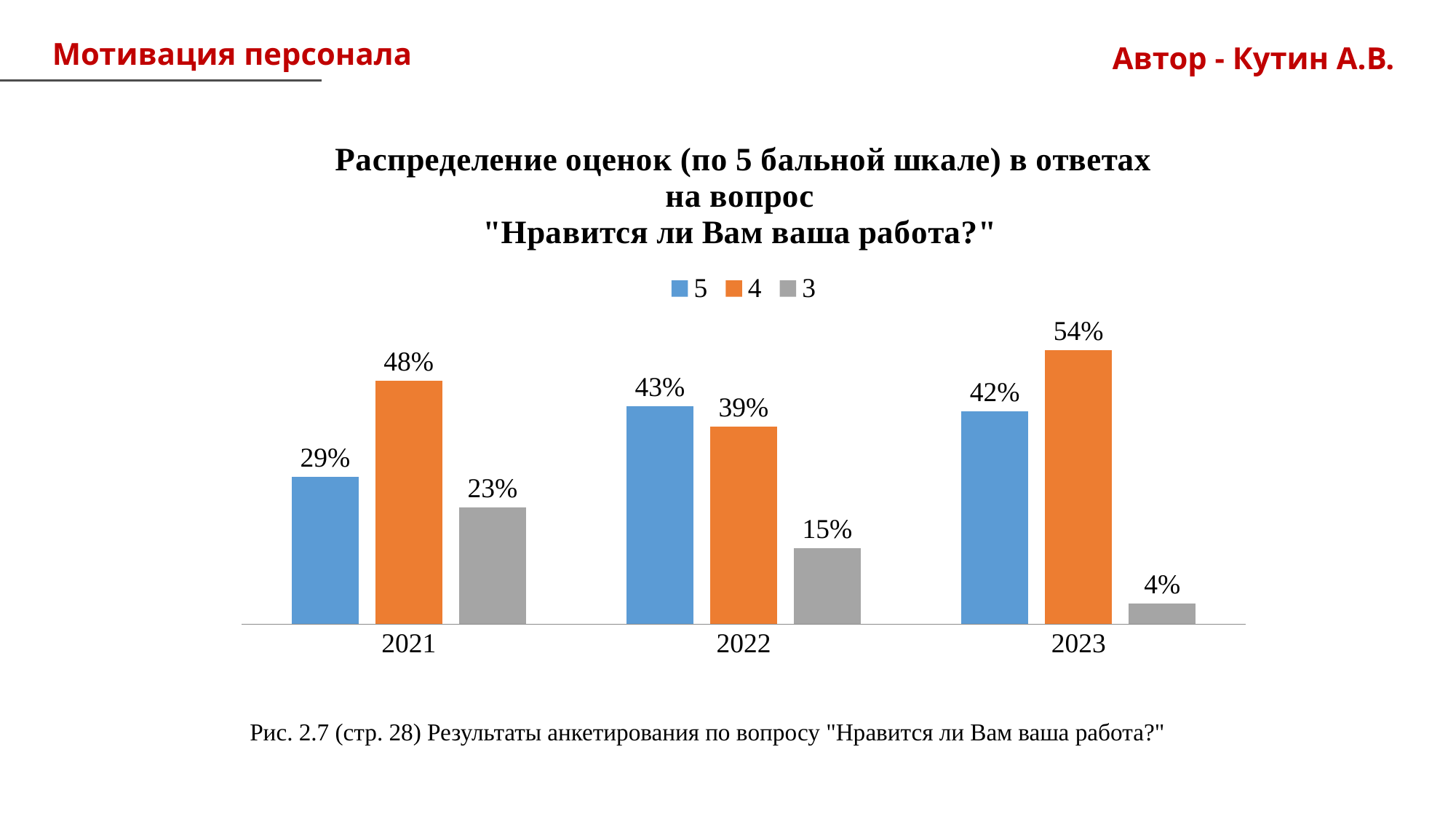
In which year was the share of rating 4 the highest? 2023 What share of respondents gave a rating of 3 in 2022? 15% What share of respondents gave a rating of 5 in 2021? 29% What share of respondents gave a rating of 4 in 2023? 54% How many series does the legend list? 3 What kind of chart is shown on the slide? Bar chart Which rating had the larger share in 2022: 5 or 4? 5 What is the difference between the share of rating 4 and rating 5 in 2021? 19% In which year was the share of rating 3 the lowest? 2023 Which colour represents the rating 4 series in the legend? Orange How many years are shown on the x axis? 3 Does the share of rating 3 rise or fall from 2021 to 2023? Fall